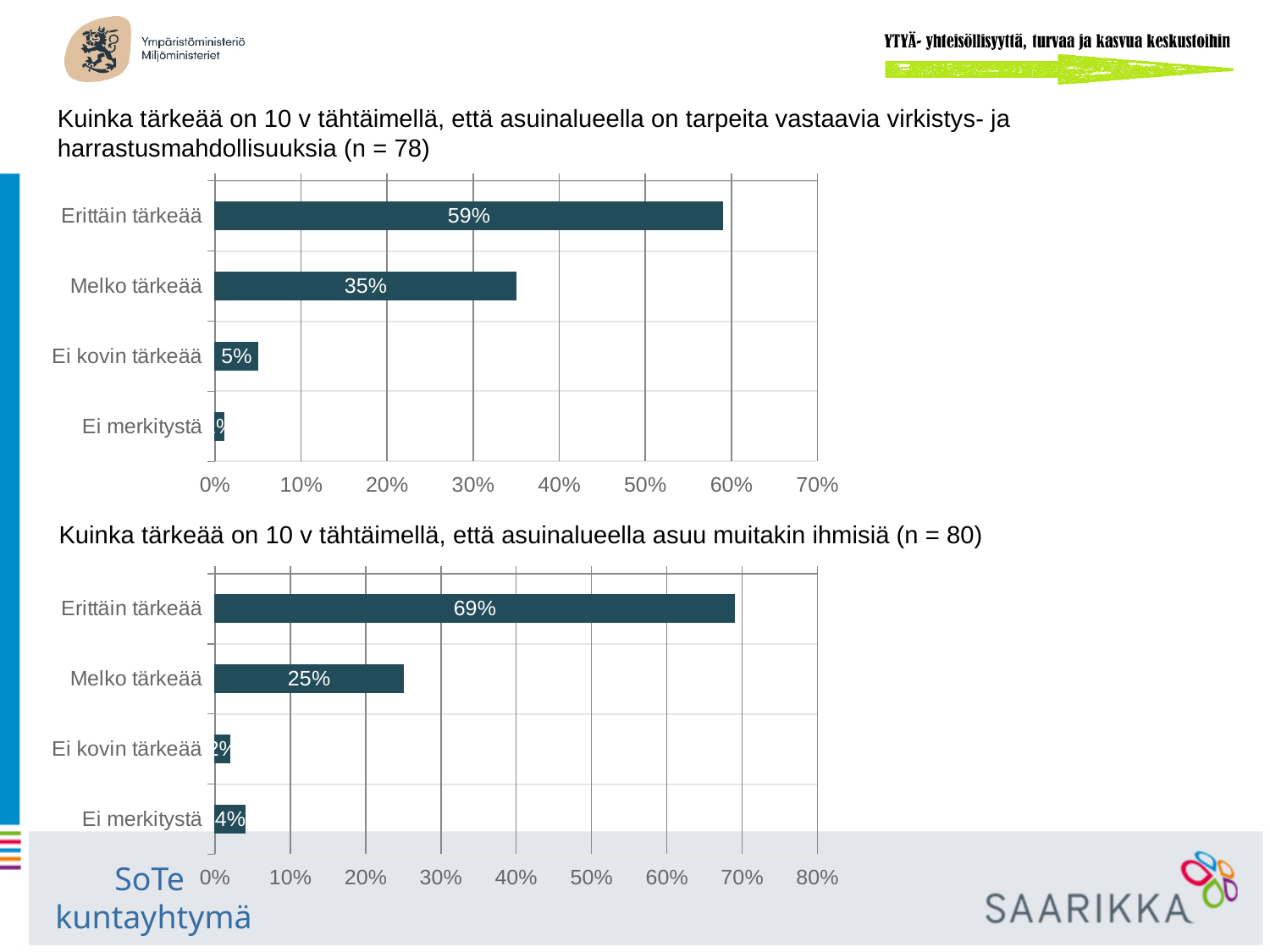
In the bottom chart (asuu muitakin ihmisiä), what is the value for Erittäin tärkeää? 69% What type of chart is the top chart (virkistys- ja harrastusmahdollisuuksia)? Bar chart In the bottom chart (asuu muitakin ihmisiä), which category has the lowest value? Ei kovin tärkeää In the top chart (virkistys- ja harrastusmahdollisuuksia), what is the value for Ei kovin tärkeää? 5% In the bottom chart (asuu muitakin ihmisiä), what is the value for Ei merkitystä? 4% In the top chart (virkistys- ja harrastusmahdollisuuksia), what is the value for Melko tärkeää? 35% In the bottom chart (asuu muitakin ihmisiä), how many categories are shown? 4 In the top chart (virkistys- ja harrastusmahdollisuuksia), is the value for Ei merkitystä greater or less than 10%? less In the top chart (virkistys- ja harrastusmahdollisuuksia), what is the difference between Erittäin tärkeää and Melko tärkeää? 24% In the top chart (virkistys- ja harrastusmahdollisuuksia), which category has the highest value? Erittäin tärkeää In the bottom chart (asuu muitakin ihmisiä), what is the value for Melko tärkeää? 25% In the top chart (virkistys- ja harrastusmahdollisuuksia), what is the value for Erittäin tärkeää? 59%